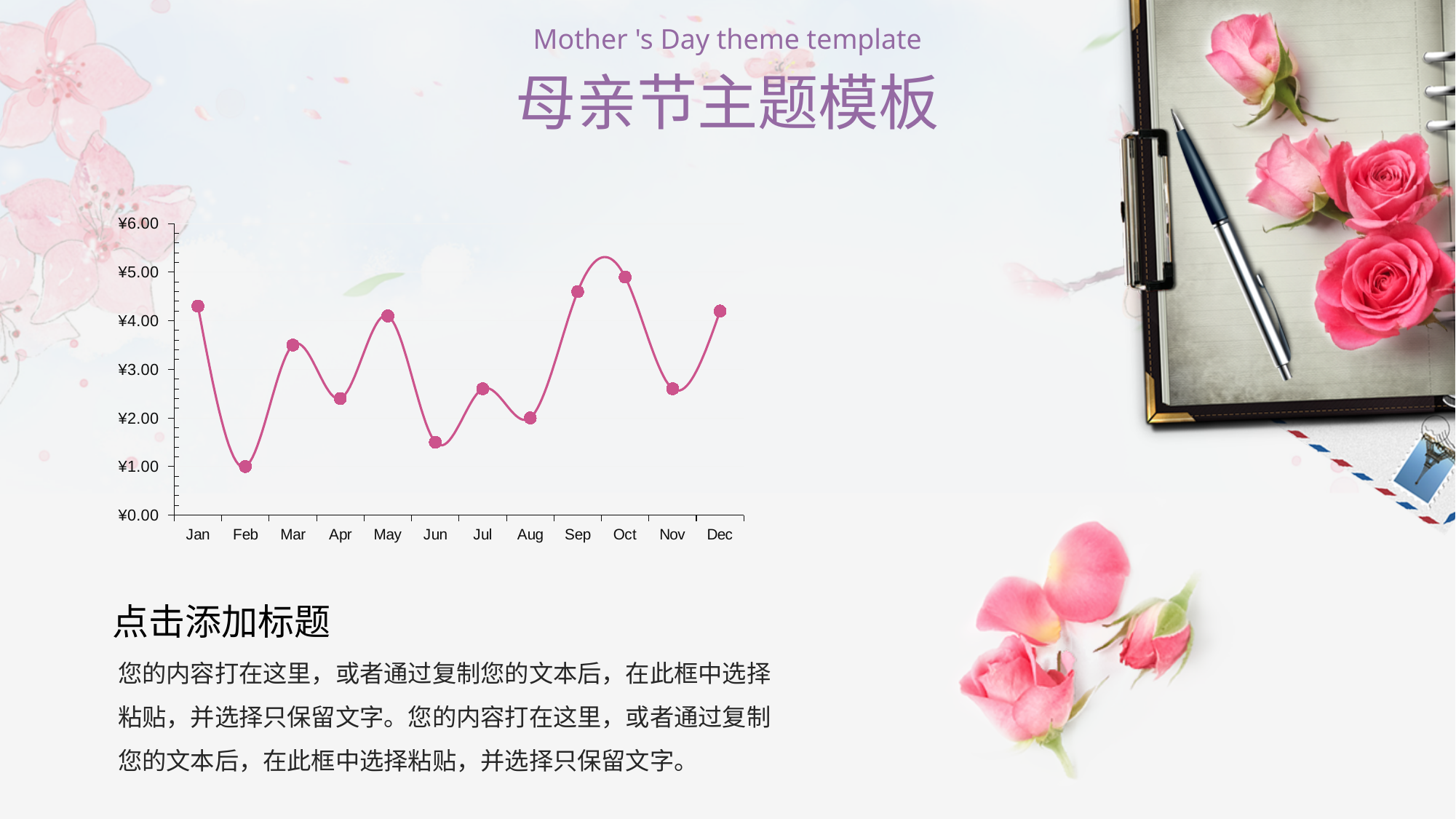
Which month has the lowest value in the chart? Feb Is the value for Apr greater or less than ¥3.00? less Does the value rise or fall from Jan to Feb? fall How many months are plotted on the x axis of the chart? 12 Which is larger, the value for Mar or the value for Apr? Mar Which month has the highest value in the chart? Oct Is the value for Mar greater or less than ¥3.00? greater Is the value for Jun greater or less than ¥2.00? less What kind of chart is shown on the slide? line chart Which is larger, the value for Sep or the value for Nov? Sep What is the highest value shown on the y axis of the chart? ¥6.00